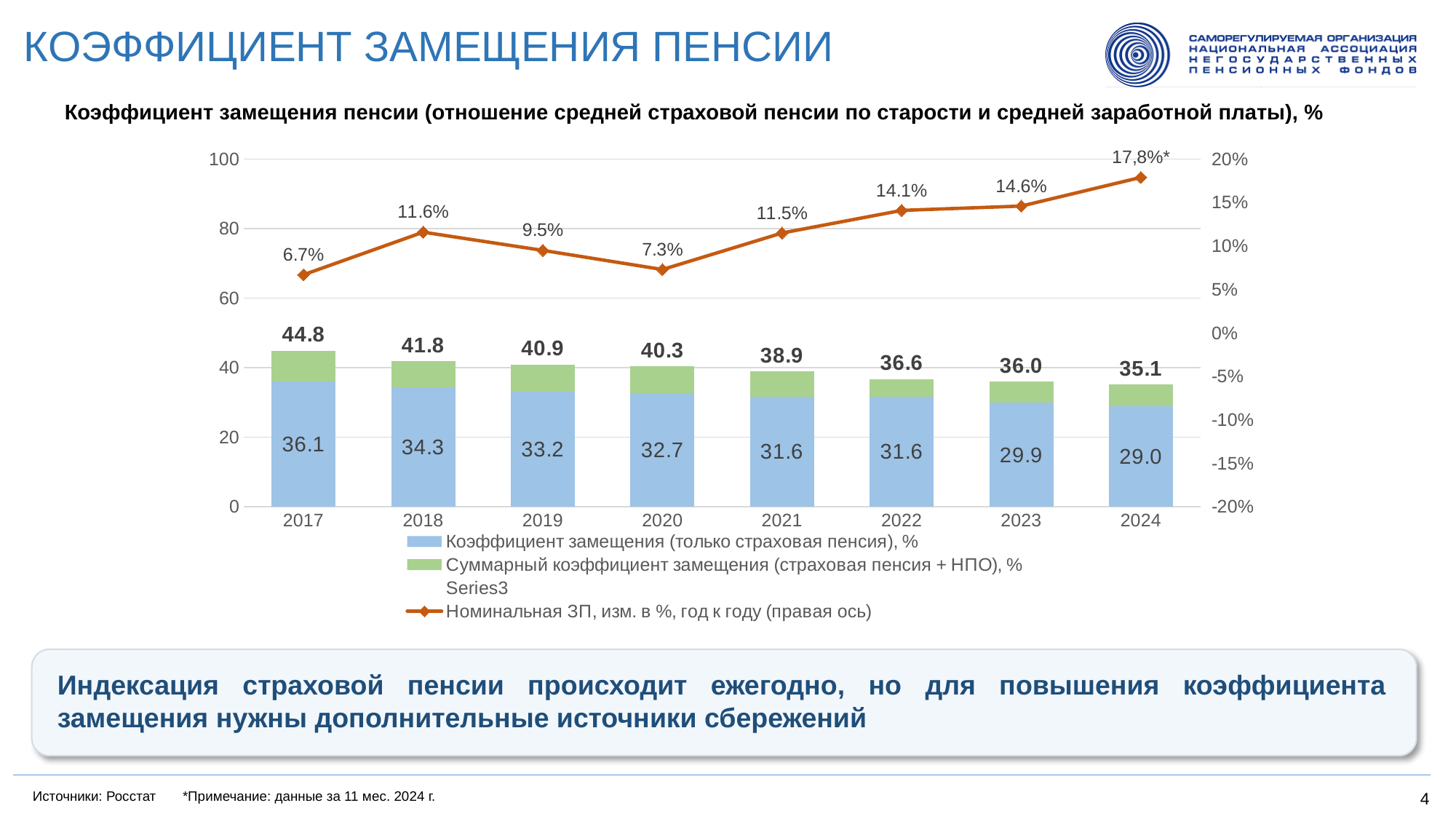
In which year is the nominal wage change (line) the highest? 2024 What is the nominal wage change shown for 2024? 17,8% Does the total replacement coefficient rise or fall from 2017 to 2024? fall What is the value of the replacement coefficient (insurance pension only) for 2017? 36.1 How many entries does the chart legend list? 4 How many years are shown on the x axis of the chart? 8 Which year has the larger nominal wage change, 2018 or 2019? 2018 What is the difference between the total replacement coefficient in 2017 and in 2024? 9.7 What is the nominal wage change (year to year) shown for 2022? 14.1% In which year is the replacement coefficient (insurance pension only) the lowest? 2024 By how much did the replacement coefficient (insurance pension only) fall from 2017 to 2024? 7.1 What is the total replacement coefficient (insurance pension + НПО) shown above the bar for 2024? 35.1